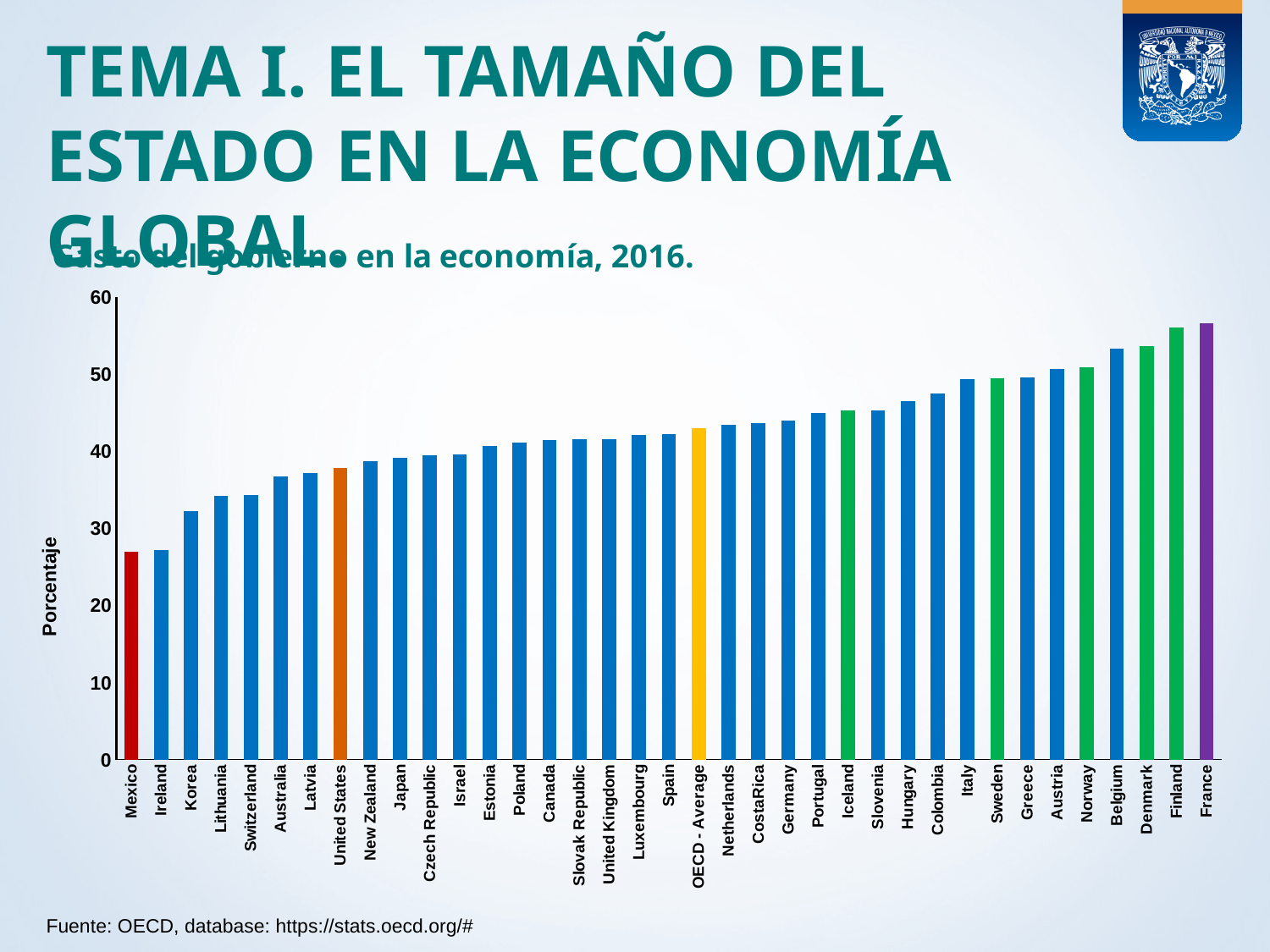
Is the value for France greater or less than 50? greater Is the value for United States greater or less than 40? less Is the value for Germany greater or less than 40? greater Which has a higher value, Spain or Norway? Norway How many bars (countries plus the OECD average) are plotted in the chart? 37 What is the label of the vertical axis? Porcentaje Do the bar values rise or fall moving from left to right along the x axis? rise What kind of chart is shown on the slide? bar chart Which has a higher value, Germany or Korea? Germany What is the title of the chart? Gasto del gobierno en la economía, 2016.